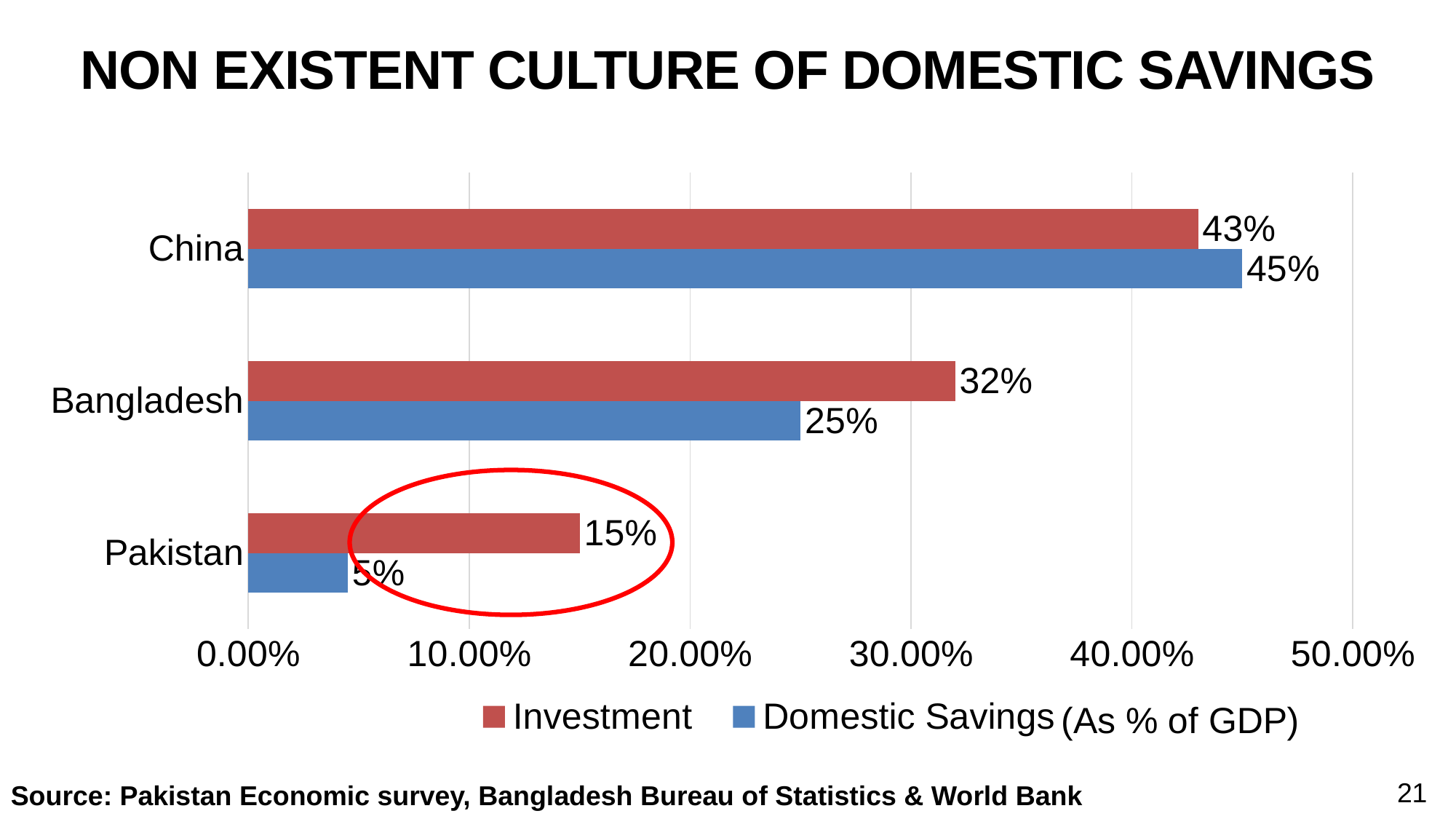
What is the difference between the Investment values for China and Pakistan? 28% How many countries are shown on the chart? 3 Which country's bars are circled in red on the chart? Pakistan What is the Domestic Savings value for Pakistan? 5% What is the Investment value for China? 43% What is the difference between the Investment and Domestic Savings values for Bangladesh? 7% How many series does the legend list? 2 What kind of chart is shown on the slide? Bar chart Which country has the highest Domestic Savings value? China What is the Domestic Savings value for Bangladesh? 25% Which is larger for China: Investment or Domestic Savings? Domestic Savings Which country has the lowest Investment value? Pakistan